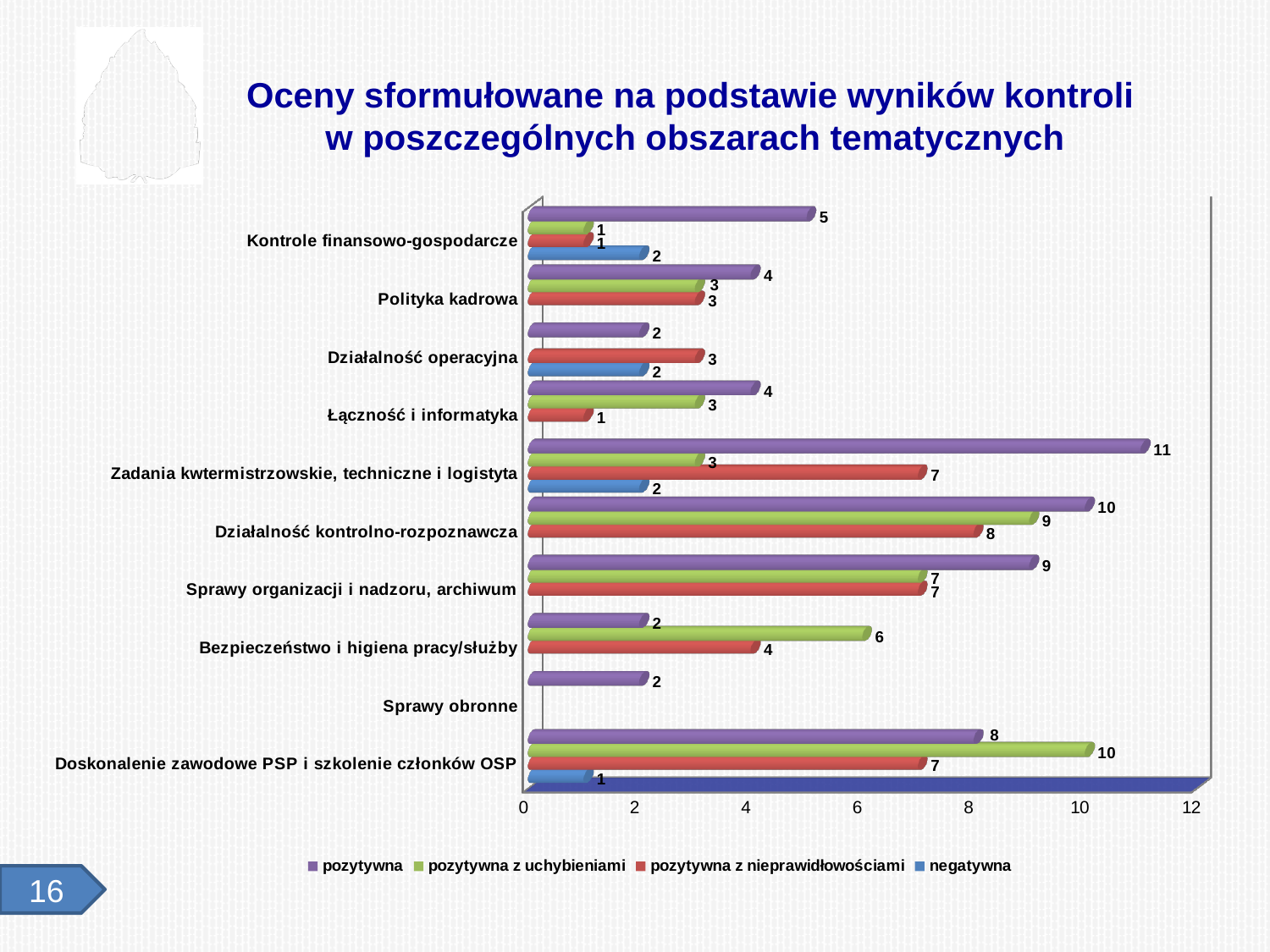
What colour represents the 'negatywna' series in the chart? blue What is the value of 'pozytywna' for 'Sprawy obronne'? 2 What is the value of 'pozytywna z nieprawidłowościami' for 'Sprawy organizacji i nadzoru, archiwum'? 7 For 'Bezpieczeństwo i higiena pracy/służby', which is larger: 'pozytywna z uchybieniami' or 'pozytywna z nieprawidłowościami'? pozytywna z uchybieniami How many categories are shown on the vertical axis of the chart? 10 What is the value of 'negatywna' for 'Kontrole finansowo-gospodarcze'? 2 Which category has the highest 'pozytywna' value? Zadania kwtermistrzowskie, techniczne i logistyta What is the difference between the 'pozytywna' and 'pozytywna z nieprawidłowościami' values for 'Działalność kontrolno-rozpoznawcza'? 2 What type of chart is shown on the slide? bar chart What is the value of 'pozytywna' for 'Zadania kwtermistrzowskie, techniczne i logistyta'? 11 How many series does the legend list? 4 What is the value of 'pozytywna z uchybieniami' for 'Doskonalenie zawodowe PSP i szkolenie członków OSP'? 10